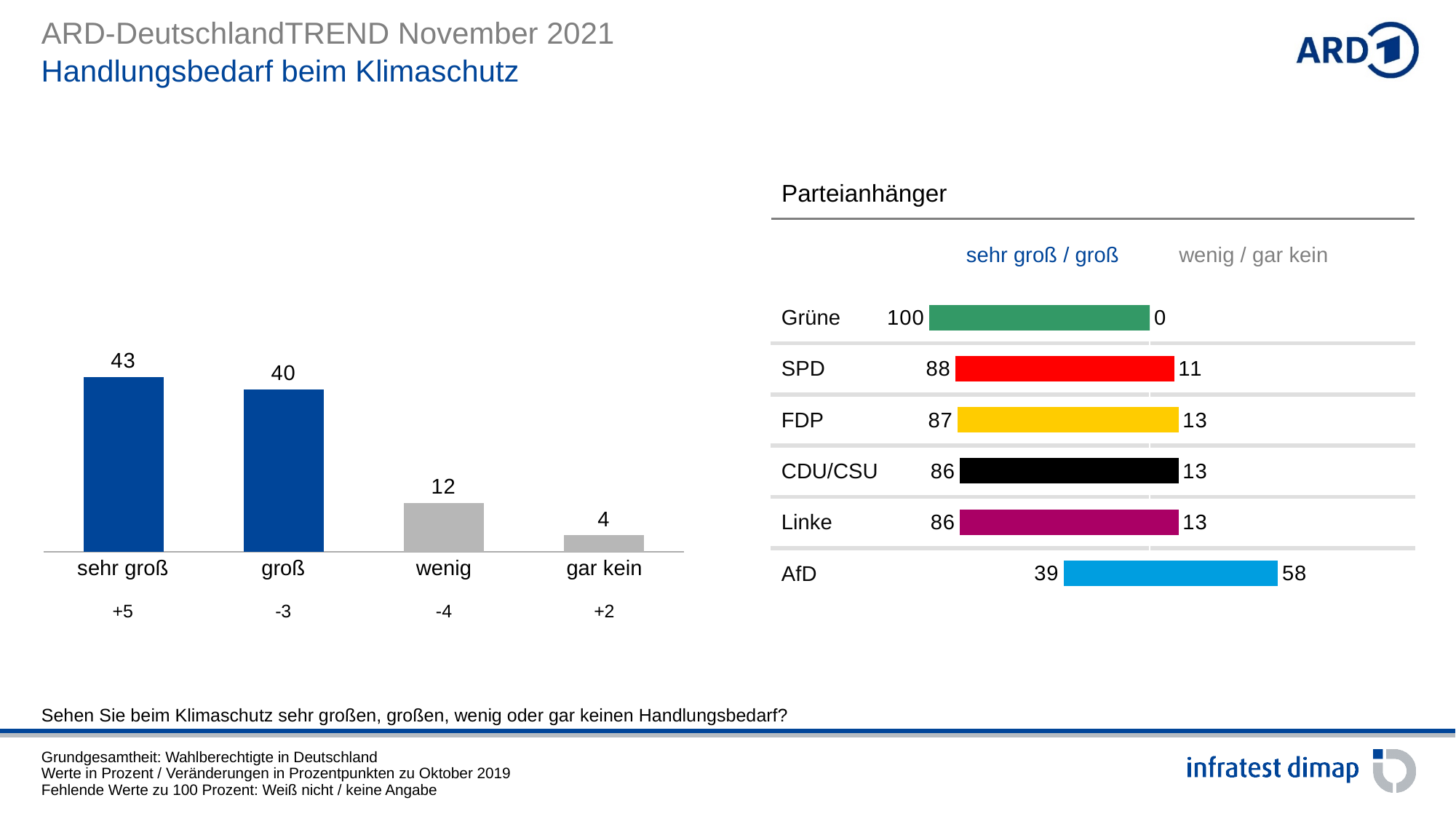
In the Parteianhänger chart, what is the "sehr groß / groß" value for SPD? 88 In the Parteianhänger chart, which party has the highest "sehr groß / groß" value? Grüne In the left bar chart, what is the value for "sehr groß"? 43 In the left bar chart, what change in percentage points is shown below "sehr groß"? +5 In the left bar chart, what is the value for "gar kein"? 4 In the left bar chart, which category has the lowest value? gar kein In the left bar chart, how many categories are shown? 4 In the left bar chart, which category has the highest value? sehr groß In the Parteianhänger chart, what is the "wenig / gar kein" value for AfD? 58 What kind of chart is the left chart? bar chart In the left bar chart, what is the difference between the values for "groß" and "wenig"? 28 In the Parteianhänger chart, how many parties are listed? 6